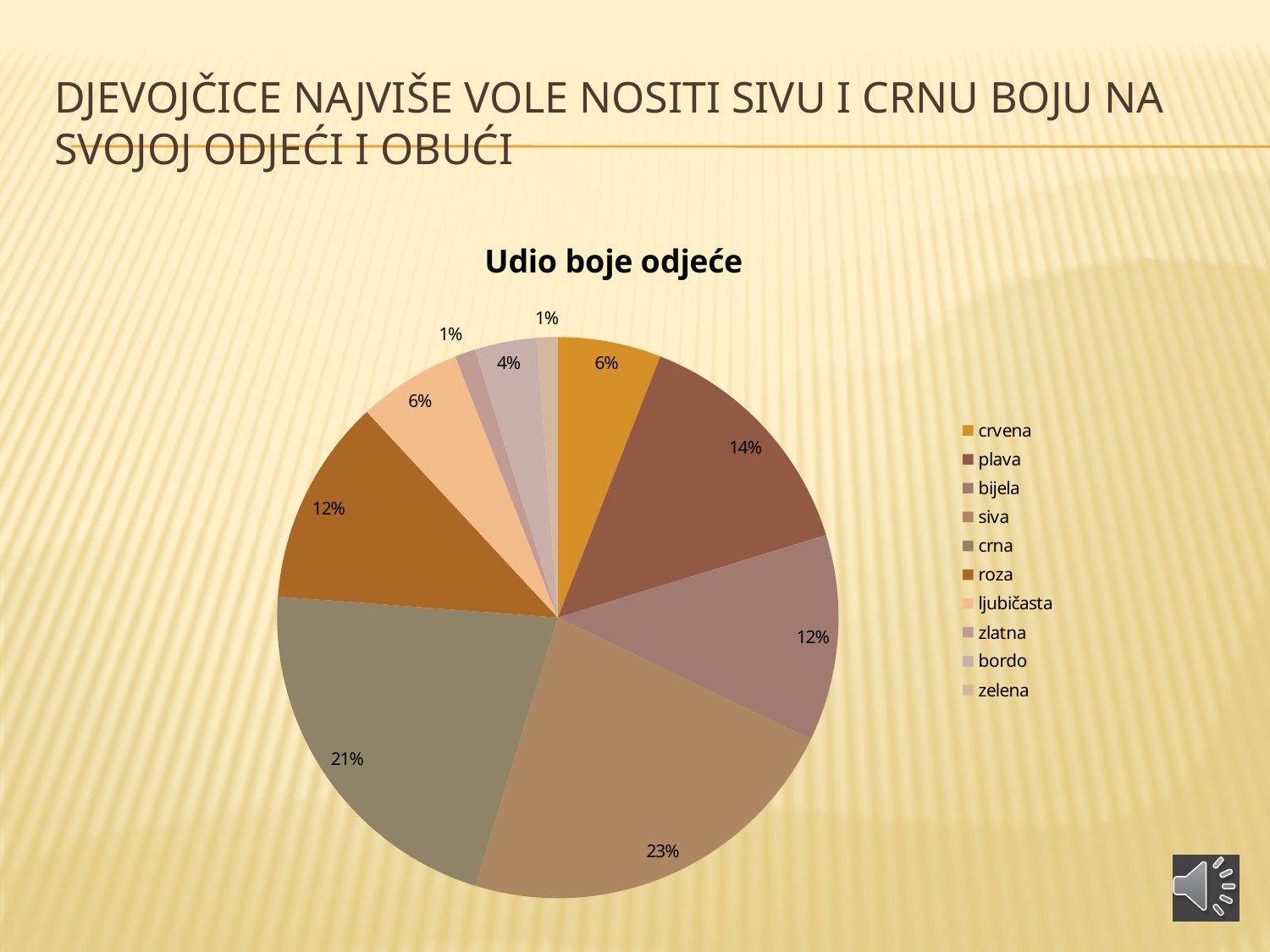
What is the difference between the shares of siva and crna? 2% What is the value for plava? 14% What share of the pie does crna have? 21% How many categories does the legend list? 10 What type of chart is shown on the slide? pie chart What is the combined share of siva and crna? 44% Which is larger, the share for plava or the share for bijela? plava What is the value for bordo? 4% What share of the pie does siva have? 23% What is the title of the pie chart? Udio boje odjeće Which legend entry is listed first? crvena Which colour has the largest share of the pie? siva